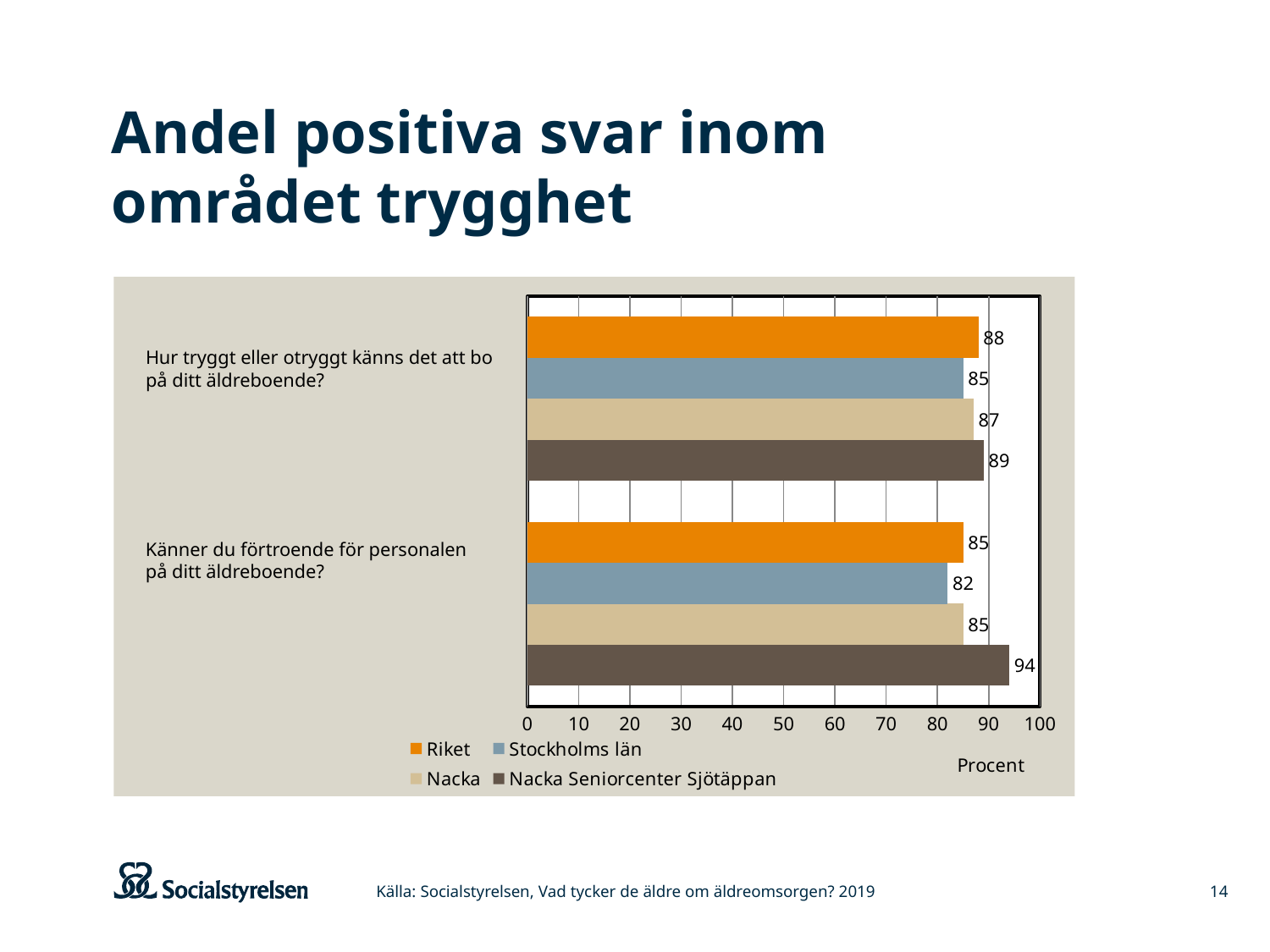
What is the difference between Nacka Seniorcenter Sjötäppan and Stockholms län for the question "Känner du förtroende för personalen på ditt äldreboende?"? 12 What is the value for Stockholms län for the question "Känner du förtroende för personalen på ditt äldreboende?"? 82 Which series has the highest value for the question "Känner du förtroende för personalen på ditt äldreboende?"? Nacka Seniorcenter Sjötäppan What is the value for Nacka for the question "Hur tryggt eller otryggt känns det att bo på ditt äldreboende?"? 87 Is the value for Stockholms län for the question "Känner du förtroende för personalen på ditt äldreboende?" greater or less than 90? less What is the value for Riket for the question "Hur tryggt eller otryggt känns det att bo på ditt äldreboende?"? 88 What is the label of the x axis? Procent How many series does the legend list? 4 What is the value for Nacka Seniorcenter Sjötäppan for the question "Känner du förtroende för personalen på ditt äldreboende?"? 94 What kind of chart is shown on the slide? Bar chart Which series has the lowest value for the question "Hur tryggt eller otryggt känns det att bo på ditt äldreboende?"? Stockholms län Which is larger for the question "Hur tryggt eller otryggt känns det att bo på ditt äldreboende?": Riket or Nacka? Riket